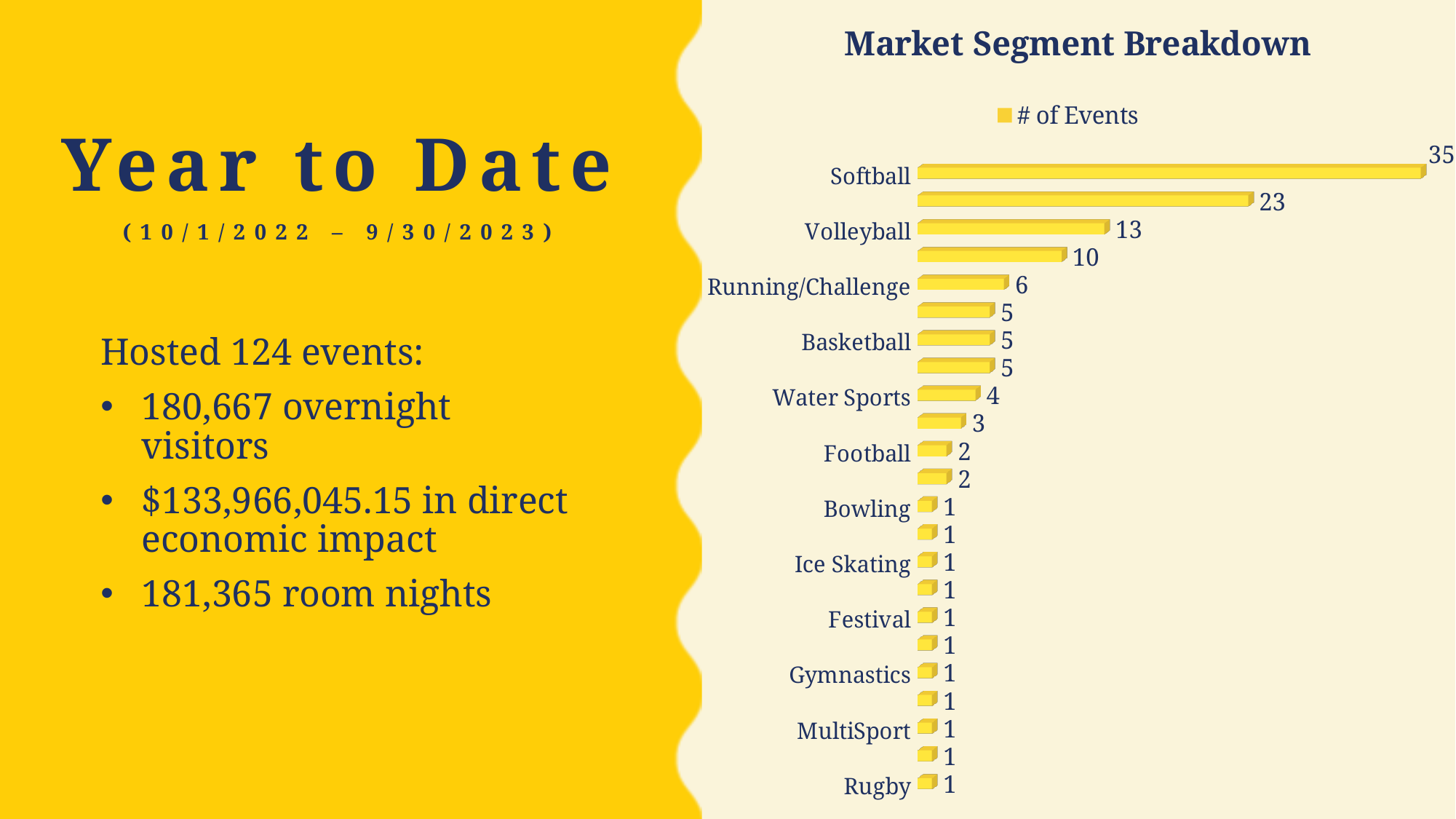
What is the number of events for Running/Challenge? 6 Which has more events, Volleyball or Basketball? Volleyball What kind of chart is shown on the slide? Bar chart What is the number of events for Football? 2 What is the number of events for Softball? 35 What is the number of events for Volleyball? 13 What is the number of events for Rugby? 1 What is the number of events for Water Sports? 4 What is the difference in number of events between Softball and Volleyball? 22 Which labeled market segment has the highest number of events? Softball What is the title of the chart? Market Segment Breakdown How many series does the legend list? 1